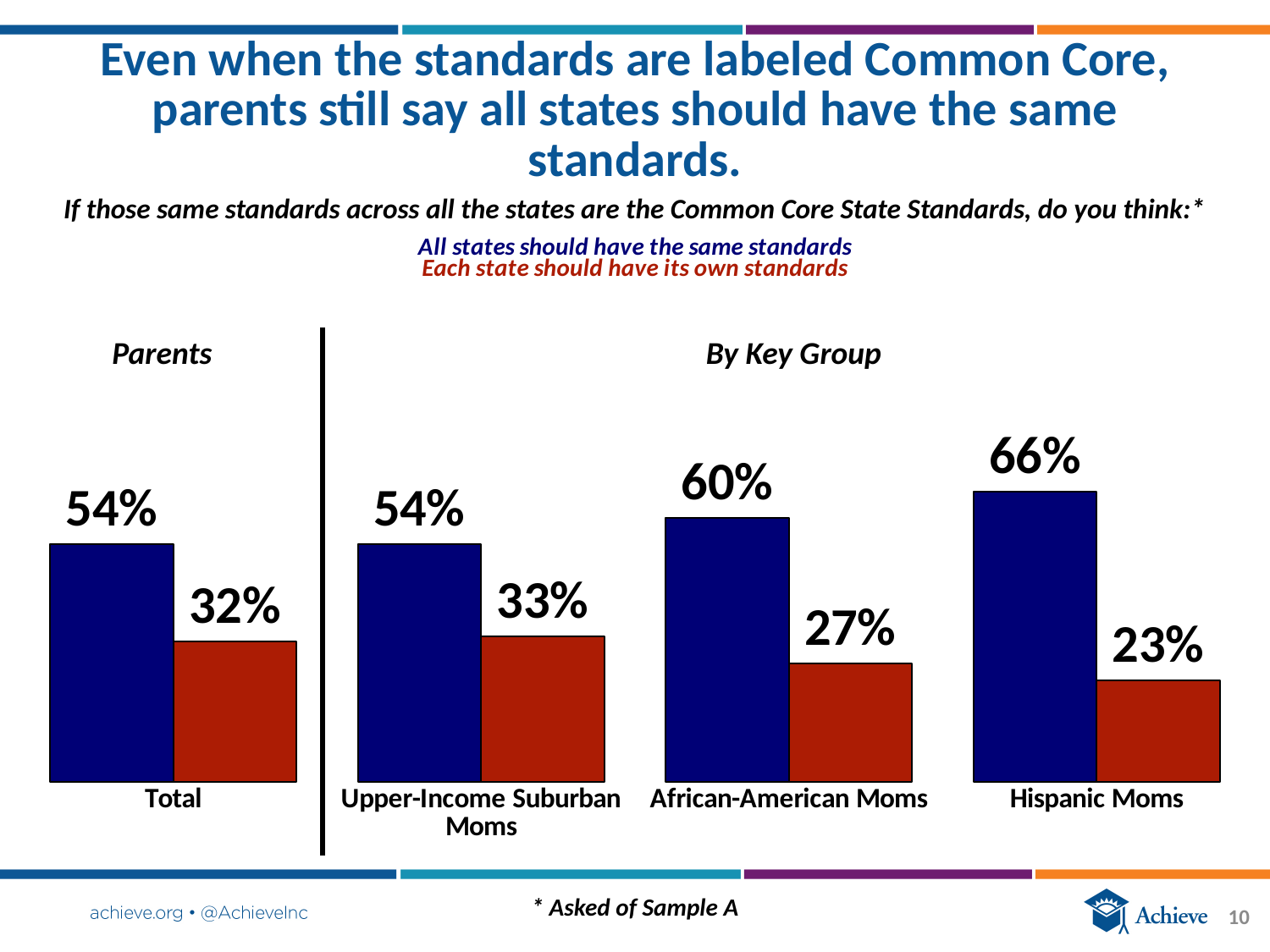
How many series does the legend list? 2 Which is larger: the percentage of African-American Moms saying all states should have the same standards, or the percentage of Upper-Income Suburban Moms saying the same? African-American Moms Which colour represents the response 'Each state should have its own standards'? Red Which group has the highest percentage saying all states should have the same standards? Hispanic Moms How many groups are shown along the x axis of the chart? 4 What percentage of Hispanic Moms say each state should have its own standards? 23% Which group has the lowest percentage saying each state should have its own standards? Hispanic Moms What percentage of African-American Moms say all states should have the same standards? 60% What percentage of Upper-Income Suburban Moms say each state should have its own standards? 33% What is the difference between the percentage of Hispanic Moms who say all states should have the same standards and the percentage who say each state should have its own standards? 43 percentage points What kind of chart is shown on the slide? Bar chart What percentage of the Total group say all states should have the same standards? 54%